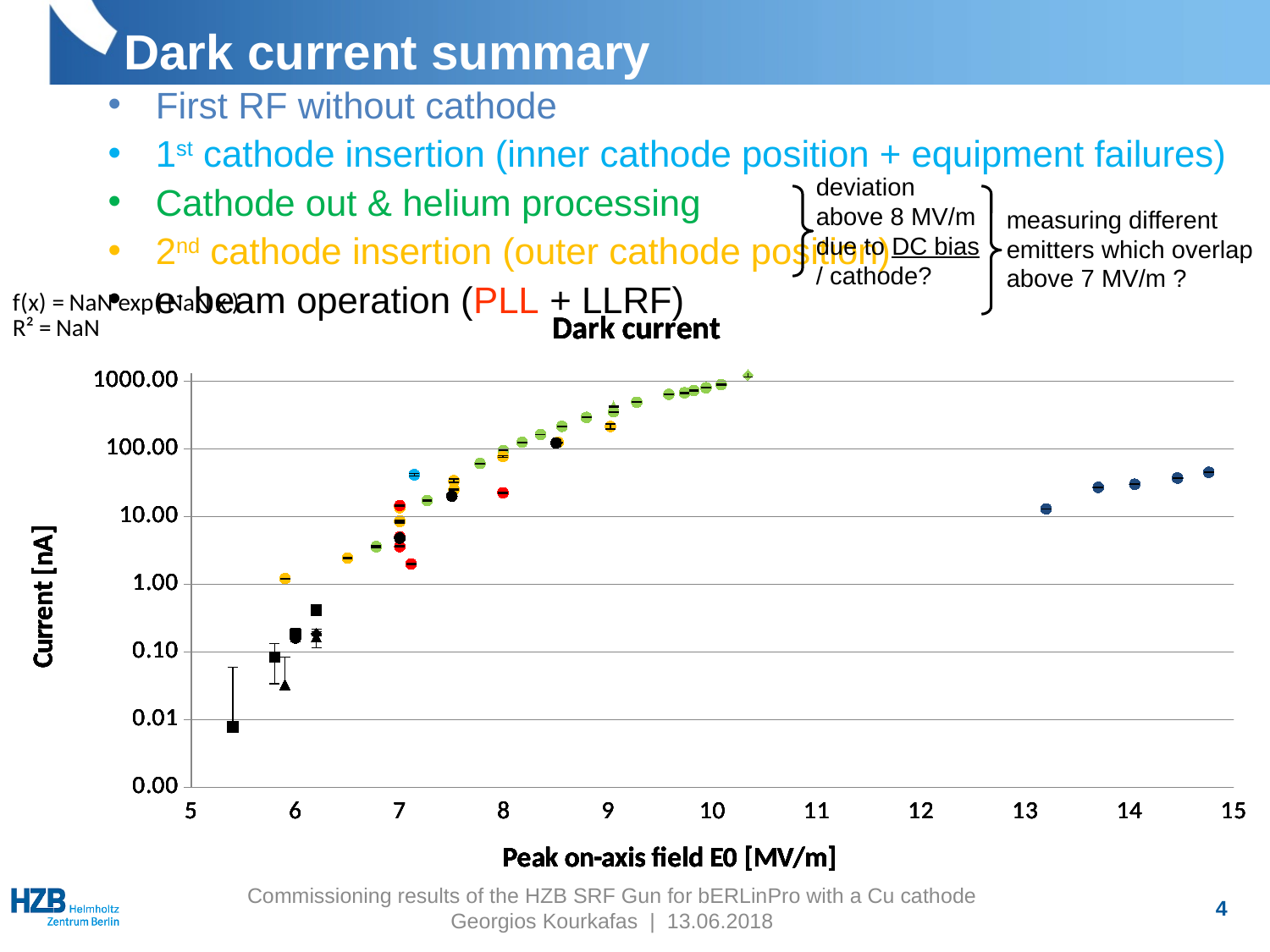
Are the dark blue points plotted between 13 and 15 MV/m greater or less than 10.00 nA? greater What kind of chart is shown on the slide? scatter chart Are the green points plotted near 10 MV/m greater or less than 100.00 nA? greater What is the label of the x axis of the chart? Peak on-axis field E0 [MV/m] What is the highest value shown on the x axis of the chart? 15 Is the red point plotted near 8 MV/m greater or less than 10.00 nA? greater What is the title of the chart? Dark current Do the dark current values generally rise or fall as the peak on-axis field increases along the x axis? rise